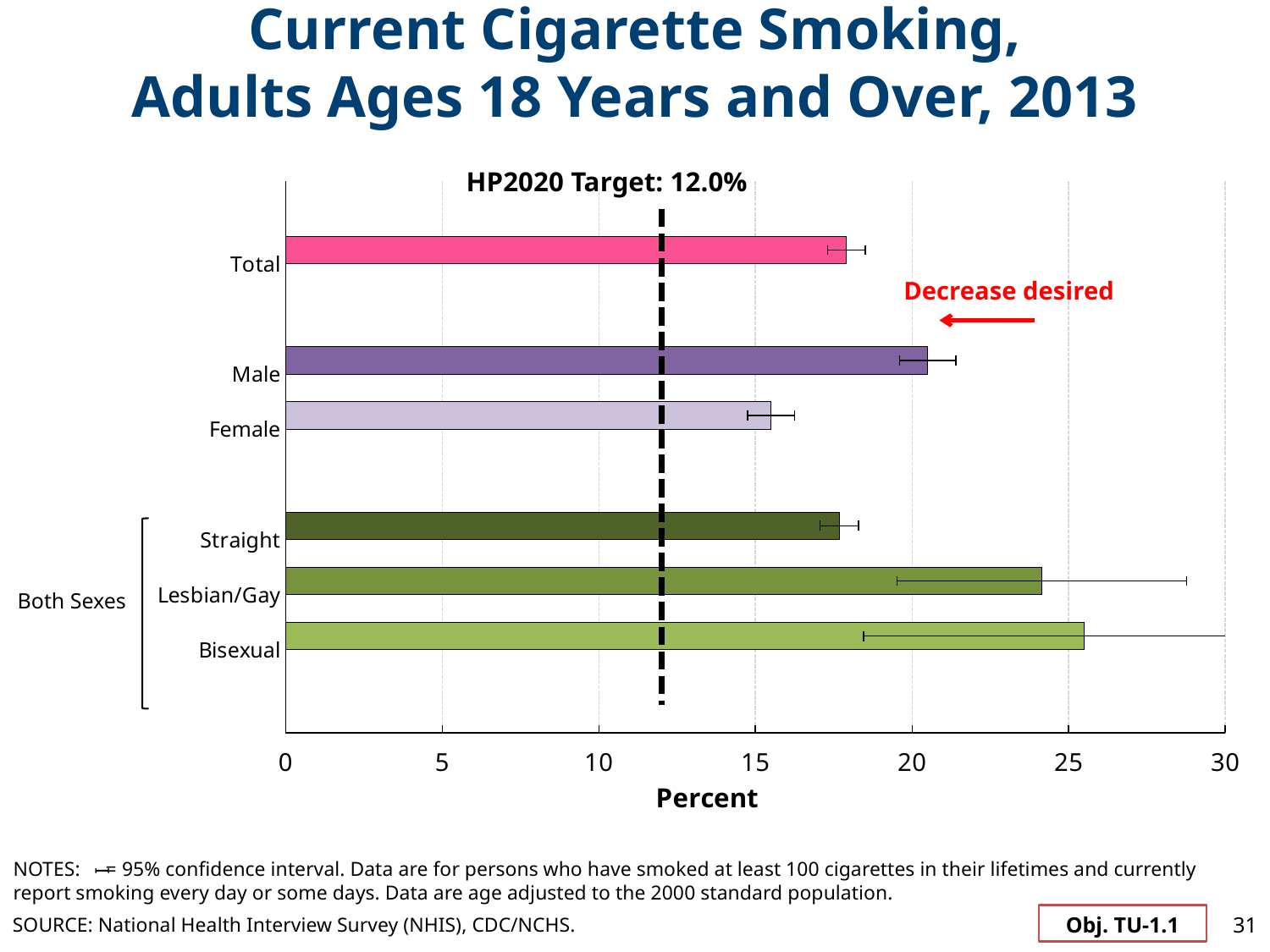
Which category has the highest current cigarette smoking percentage? Bisexual Is the value for Bisexual greater or less than 25? greater What is the HP2020 Target value shown on the chart? 12.0% Is the value for Female greater or less than 20? less How many categories (bars) are plotted in the chart? 6 Which category has the lowest current cigarette smoking percentage? Female Which is larger, the value for Lesbian/Gay or the value for Straight? Lesbian/Gay Is the value for Male greater or less than 20? greater What kind of chart is shown on the slide? bar chart Which is larger, the value for Male or the value for Female? Male What is the label of the x axis? Percent